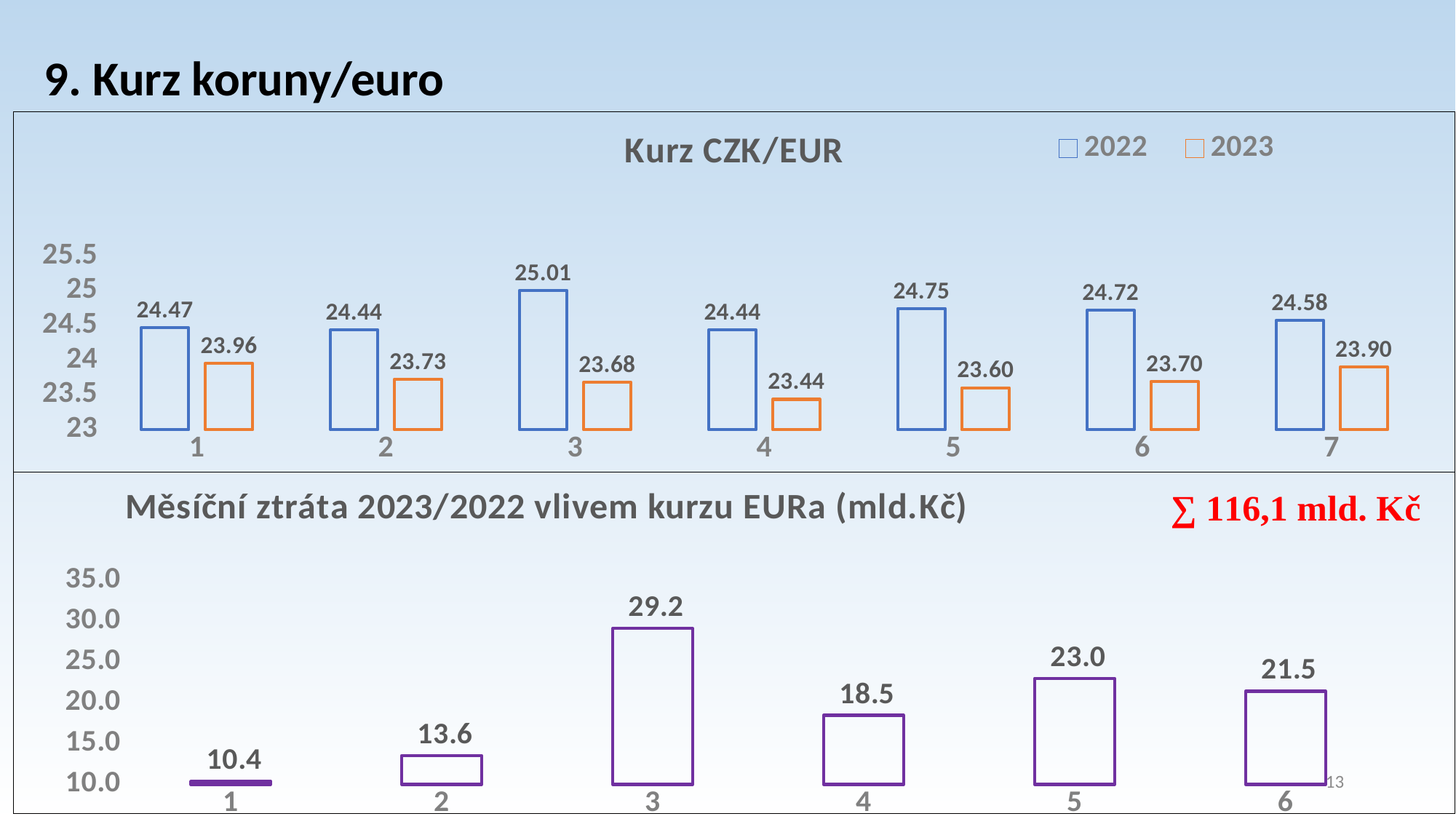
In the 'Kurz CZK/EUR' chart, how many series does the legend list? 2 In the 'Měsíční ztráta 2023/2022 vlivem kurzu EURa (mld.Kč)' chart, which category has the lowest value? 1 In the 'Kurz CZK/EUR' chart, what is the difference between the 2022 and 2023 values for category 1? 0.51 What kind of chart is the bottom chart on the slide? bar chart In the 'Kurz CZK/EUR' chart, what is the 2023 value for category 4? 23.44 In the 'Měsíční ztráta 2023/2022 vlivem kurzu EURa (mld.Kč)' chart, which category has the highest value? 3 In the 'Kurz CZK/EUR' chart, which category has the highest 2022 value? 3 In the 'Měsíční ztráta 2023/2022 vlivem kurzu EURa (mld.Kč)' chart, what is the value for category 5? 23.0 In the 'Měsíční ztráta 2023/2022 vlivem kurzu EURa (mld.Kč)' chart, which is larger, the value for category 4 or category 6? 6 In the 'Kurz CZK/EUR' chart, how many categories are shown on the x axis? 7 In the 'Kurz CZK/EUR' chart, what is the 2022 value for category 3? 25.01 In the 'Kurz CZK/EUR' chart, which category has the lowest 2023 value? 4